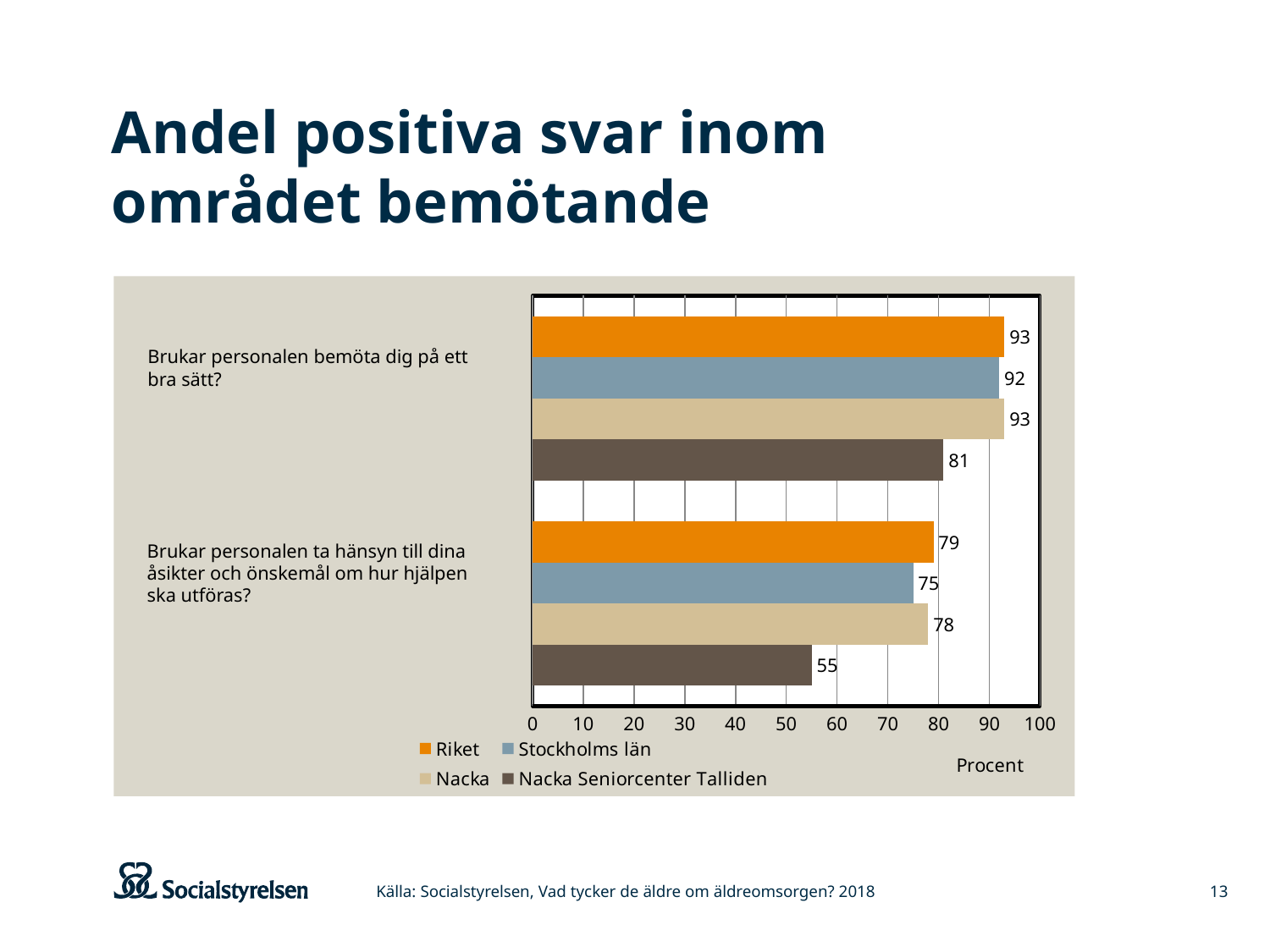
How many series does the legend list? 4 Which is larger: the Nacka value or the Nacka Seniorcenter Talliden value on the question "Brukar personalen bemöta dig på ett bra sätt?"? Nacka What is the value for Riket on the question "Brukar personalen ta hänsyn till dina åsikter och önskemål om hur hjälpen ska utföras?"? 79 What kind of chart is shown on the slide? bar chart What is the difference between the Riket value and the Stockholms län value on the question "Brukar personalen ta hänsyn till dina åsikter och önskemål om hur hjälpen ska utföras?"? 4 Which series has the lowest value on the question "Brukar personalen ta hänsyn till dina åsikter och önskemål om hur hjälpen ska utföras?"? Nacka Seniorcenter Talliden What is the value for Nacka Seniorcenter Talliden on the question "Brukar personalen bemöta dig på ett bra sätt?"? 81 What is the difference between the Nacka value and the Nacka Seniorcenter Talliden value on the question "Brukar personalen ta hänsyn till dina åsikter och önskemål om hur hjälpen ska utföras?"? 23 How many questions (categories) are shown on the chart? 2 What is the label on the horizontal axis of the chart? Procent What is the value for Stockholms län on the question "Brukar personalen bemöta dig på ett bra sätt?"? 92 Is the value for Nacka Seniorcenter Talliden on the question "Brukar personalen ta hänsyn till dina åsikter och önskemål om hur hjälpen ska utföras?" greater or less than 60? less